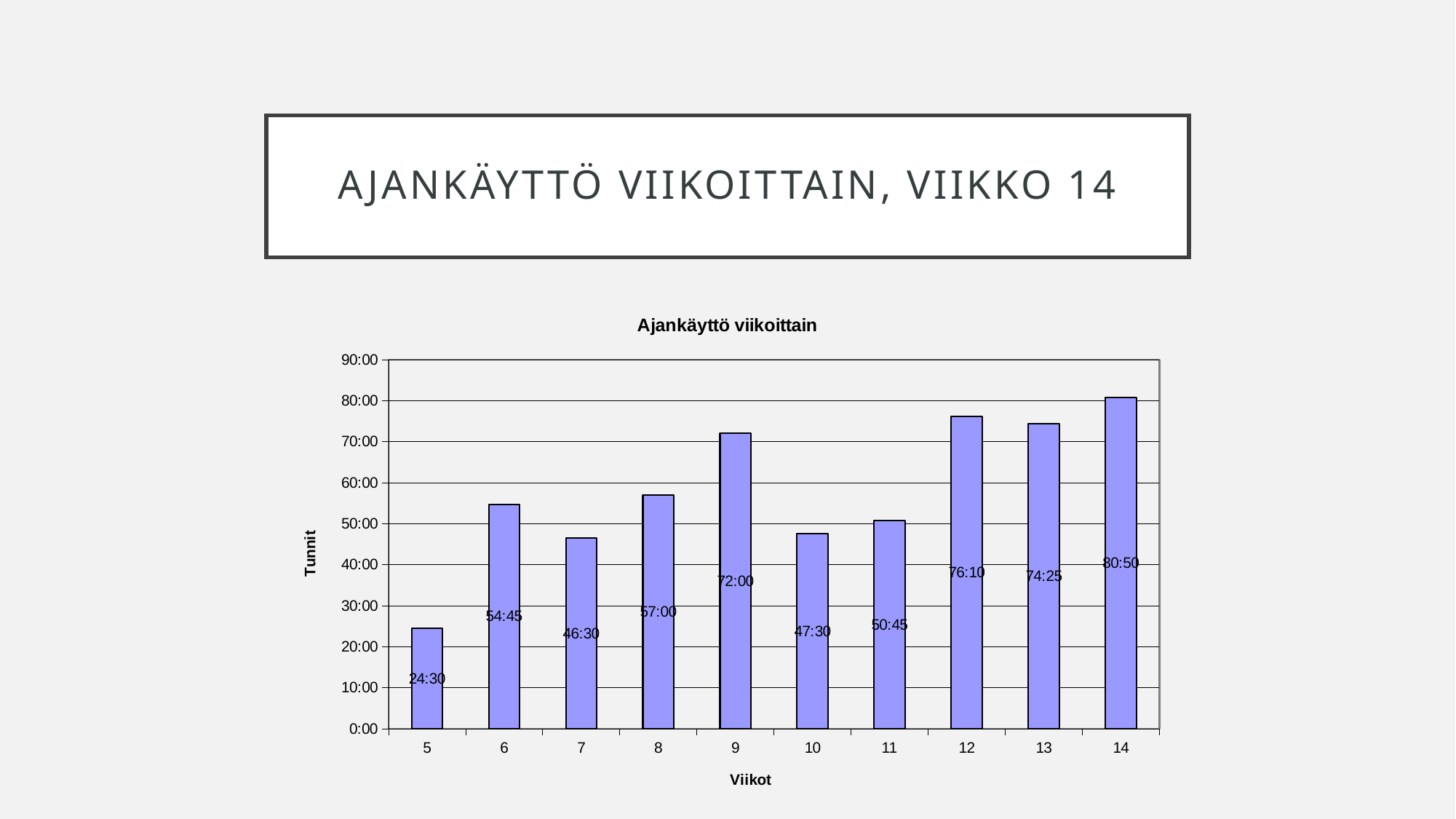
What is the value for week 9? 72:00 What kind of chart is shown on the slide? bar chart Which week has the lowest value? 5 Is the value for week 10 greater or less than 50:00? less What is the value for week 12? 76:10 How many weeks are shown on the x axis? 10 Which week has the highest value? 14 What is the difference between the values for week 9 and week 8? 15:00 Which is larger, the value for week 6 or the value for week 7? week 6 What is the difference between the values for week 14 and week 5? 56:20 What is the label of the y axis? Tunnit What is the value for week 5? 24:30